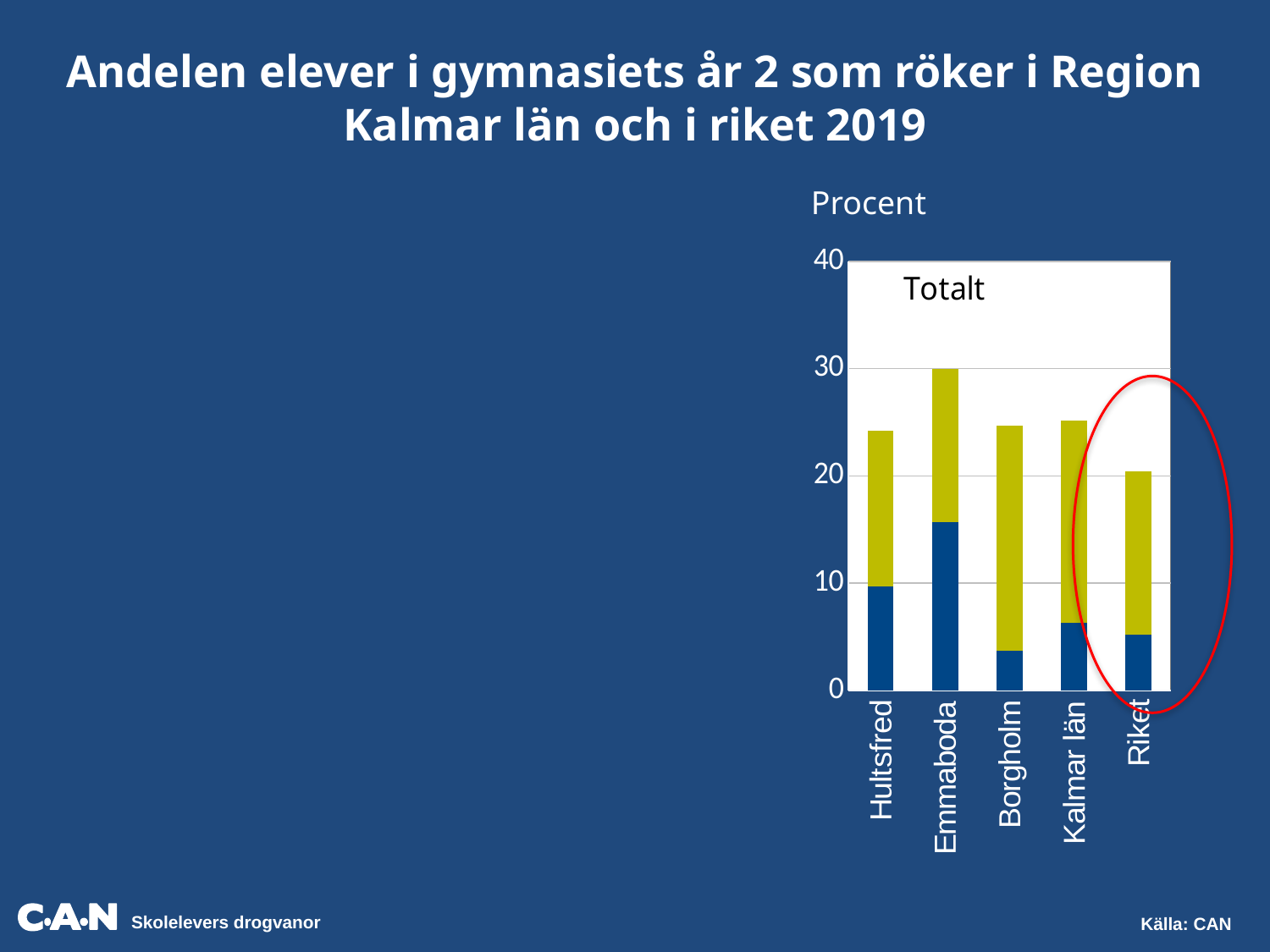
Which category has the highest total bar? Emmaboda Which category has the lowest total bar? Riket Is the total value for Kalmar län greater or less than 30? less How many categories are shown on the x axis of the chart? 5 Is the blue segment for Borgholm greater or less than 10? less What is the title printed inside the chart area? Totalt What kind of chart is shown on the slide? Stacked bar chart Which has a larger total bar, Emmaboda or Hultsfred? Emmaboda Is the blue segment for Emmaboda greater or less than 10? greater Which category's bar is circled in red? Riket What is the total value of the Emmaboda bar? 30